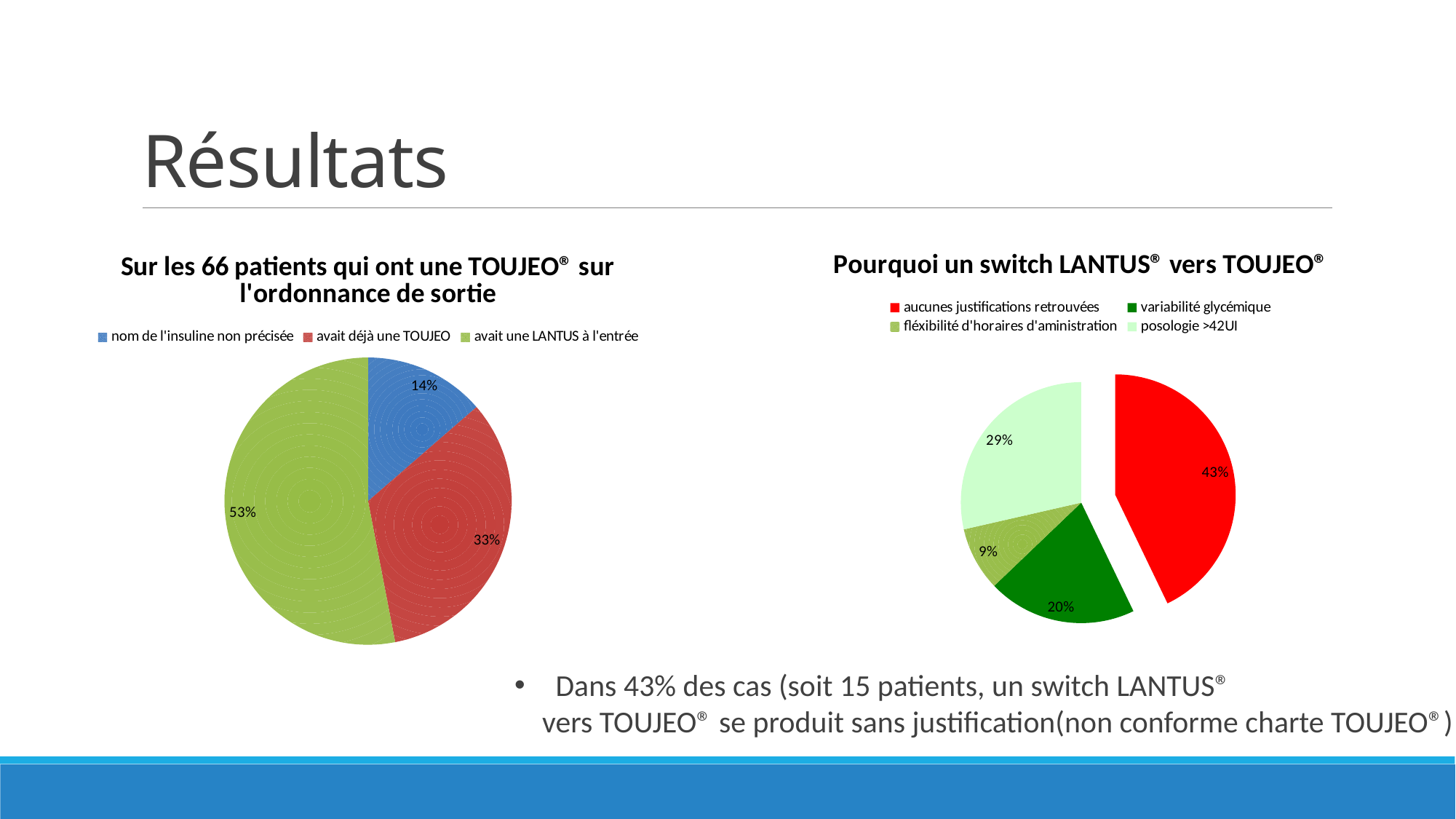
In the left pie chart, how many slices are there? 3 In the left pie chart (Sur les 66 patients qui ont une TOUJEO sur l'ordonnance de sortie), what share is labelled for 'avait une LANTUS à l'entrée'? 53% What type of chart is used on the right side of the slide? pie chart In the left pie chart, which category has the largest slice? avait une LANTUS à l'entrée In the right pie chart, what share is labelled for 'variabilité glycémique'? 20% In the right pie chart (Pourquoi un switch LANTUS vers TOUJEO), what share is labelled for 'aucunes justifications retrouvées'? 43% In the right pie chart, what is the difference in percentage points between 'aucunes justifications retrouvées' and 'posologie >42UI'? 14 In the left pie chart, which category has the smallest slice? nom de l'insuline non précisée In the right pie chart, which category has the smallest slice? fléxibilité d'horaires d'aministration In the left pie chart, what share is labelled for 'nom de l'insuline non précisée'? 14% In the left pie chart, what share is labelled for 'avait déjà une TOUJEO'? 33% In the right pie chart, what share is labelled for 'posologie >42UI'? 29%